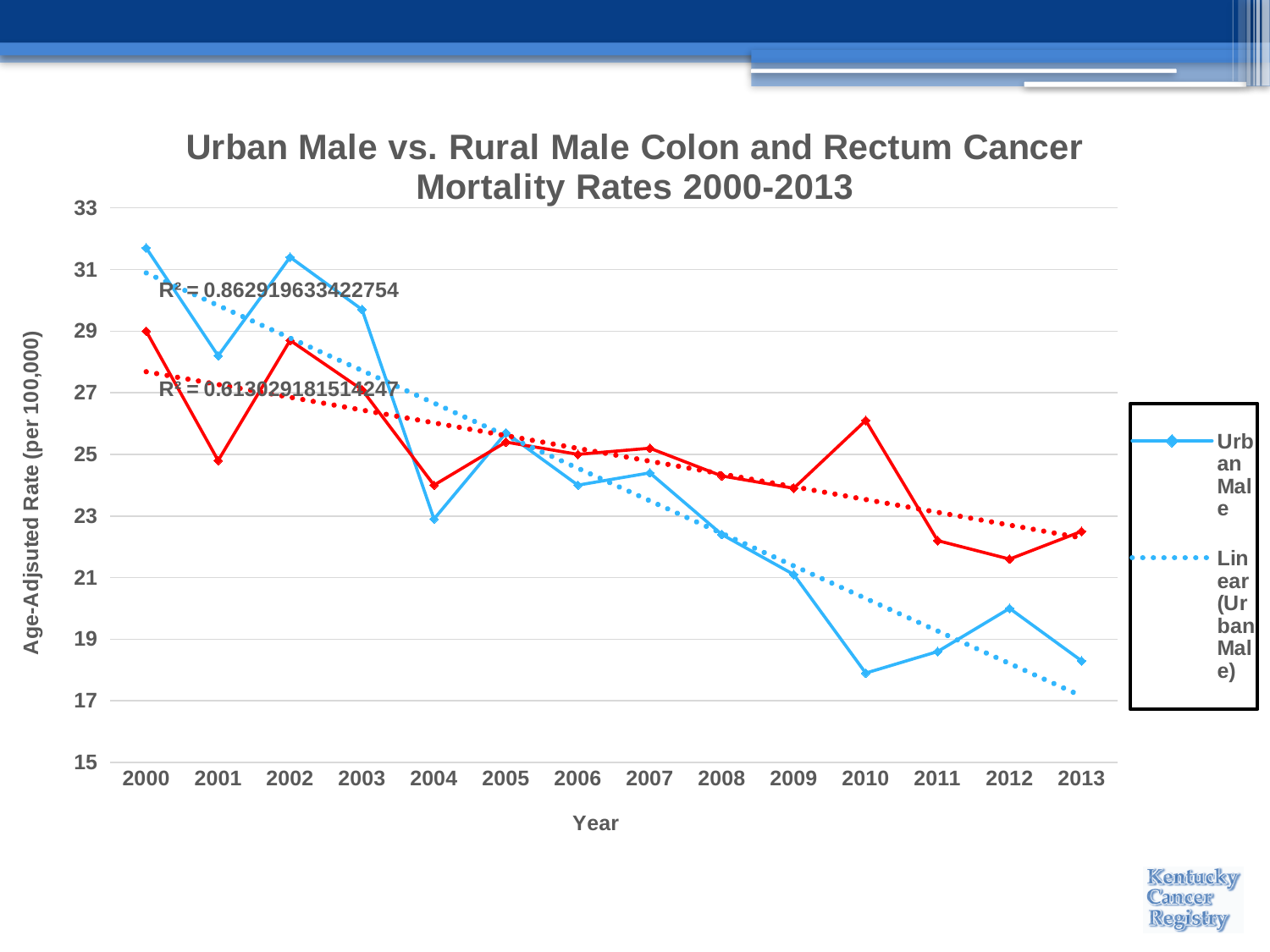
Is the Urban Male value for 2010 greater or less than 19? less In which year is the Urban Male value lowest? 2010 How many years are plotted along the x axis? 14 Is the Urban Male value for 2000 greater or less than 31? greater In 2010, which is larger, the Urban Male value or the Rural Male (red line) value? Rural Male In 2000, which is larger, the Urban Male value or the Rural Male (red line) value? Urban Male What is the title of the chart? Urban Male vs. Rural Male Colon and Rectum Cancer Mortality Rates 2000-2013 What is the label of the vertical axis? Age-Adjusted Rate (per 100,000) Does the Urban Male series generally rise or fall from 2000 to 2013? fall What kind of chart is shown on the slide? line chart Is the Rural Male (red line) value for 2010 greater or less than 25? greater